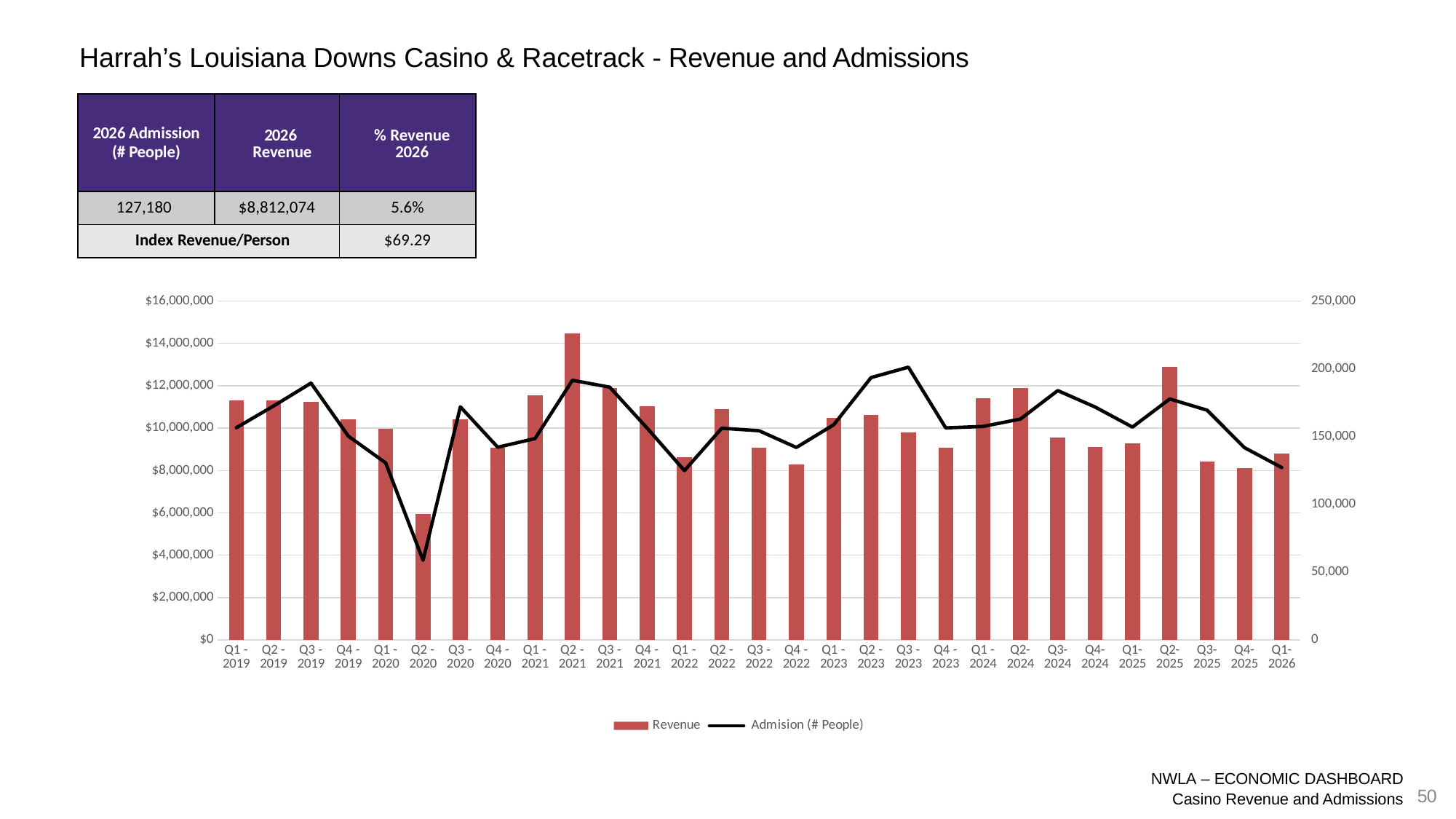
What kind of chart is shown on the slide? A bar chart combined with a line chart What are the two series named in the chart legend? Revenue and Admision (# People) Which quarter has the lowest point on the Admision (# People) line? Q2 - 2020 Is the Revenue value for Q1- 2026 greater or less than $10,000,000? less How many quarters are plotted along the x axis of the chart? 29 Is the Revenue value for Q2 - 2021 greater or less than $14,000,000? greater Which quarter has the lowest Revenue bar? Q2 - 2020 Is the Admision (# People) value for Q2 - 2020 greater or less than 100,000? less Do the Revenue bars rise or fall from Q2- 2025 to Q4- 2025? fall How many series does the chart legend list? 2 Which quarter has the larger Revenue bar, Q2 - 2021 or Q2- 2025? Q2 - 2021 Which quarter has the highest Revenue bar? Q2 - 2021